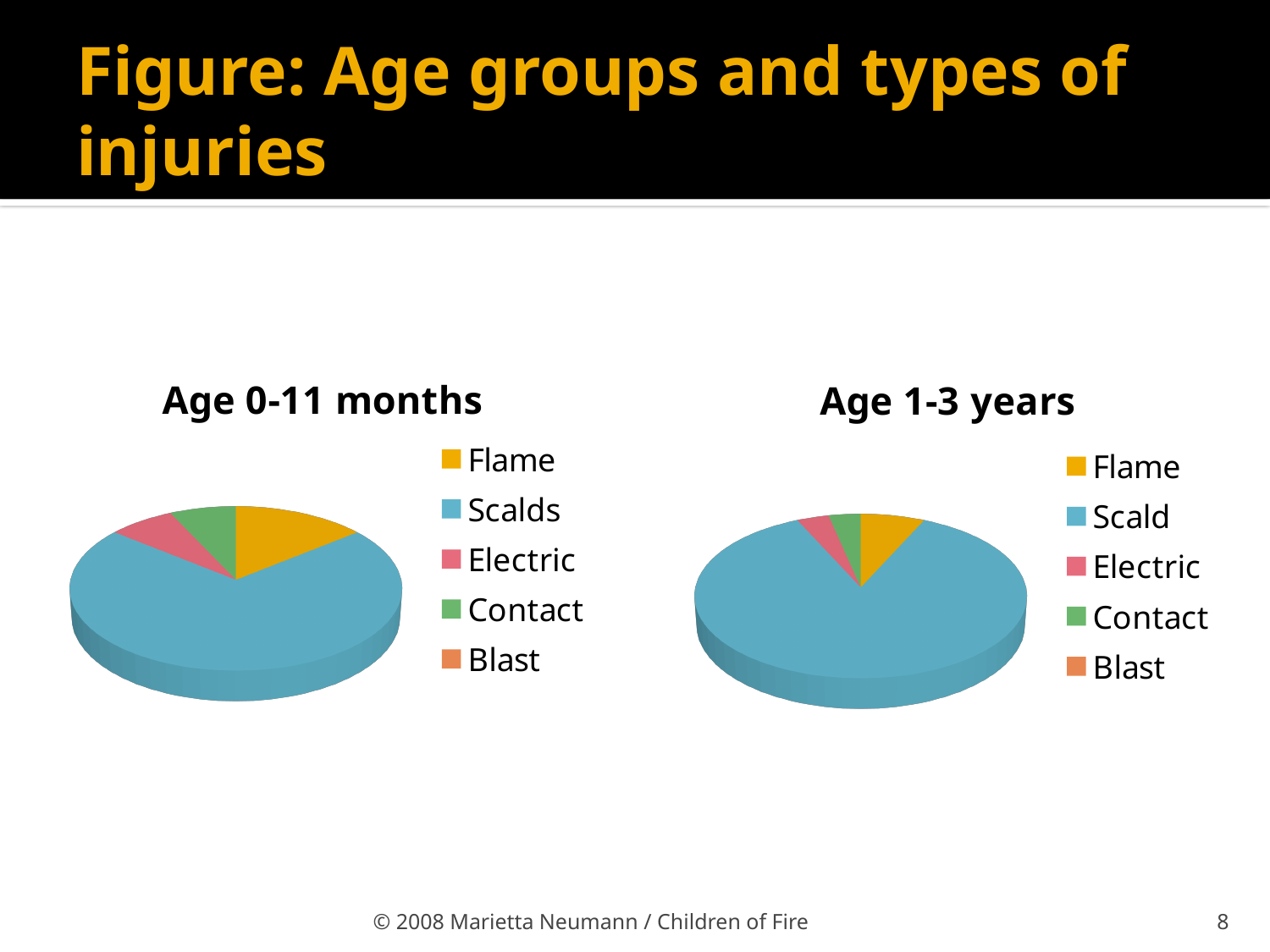
What kind of chart is the "Age 1-3 years" chart? Pie chart In the "Age 1-3 years" chart, which injury type has the largest slice? Scald In the "Age 0-11 months" chart, which slice is larger, Flame or Electric? Flame In the "Age 1-3 years" chart, which slice is larger, Scald or Flame? Scald In the "Age 1-3 years" chart, which slice is larger, Flame or Contact? Flame What kind of chart is the "Age 0-11 months" chart? Pie chart How many injury types are listed in the legend of the "Age 0-11 months" chart? 5 How many injury types are listed in the legend of the "Age 1-3 years" chart? 5 What is the title of the pie chart on the left of the slide? Age 0-11 months What colour represents Scalds in the "Age 0-11 months" chart? Blue In the "Age 0-11 months" chart, which injury type has the largest slice? Scalds